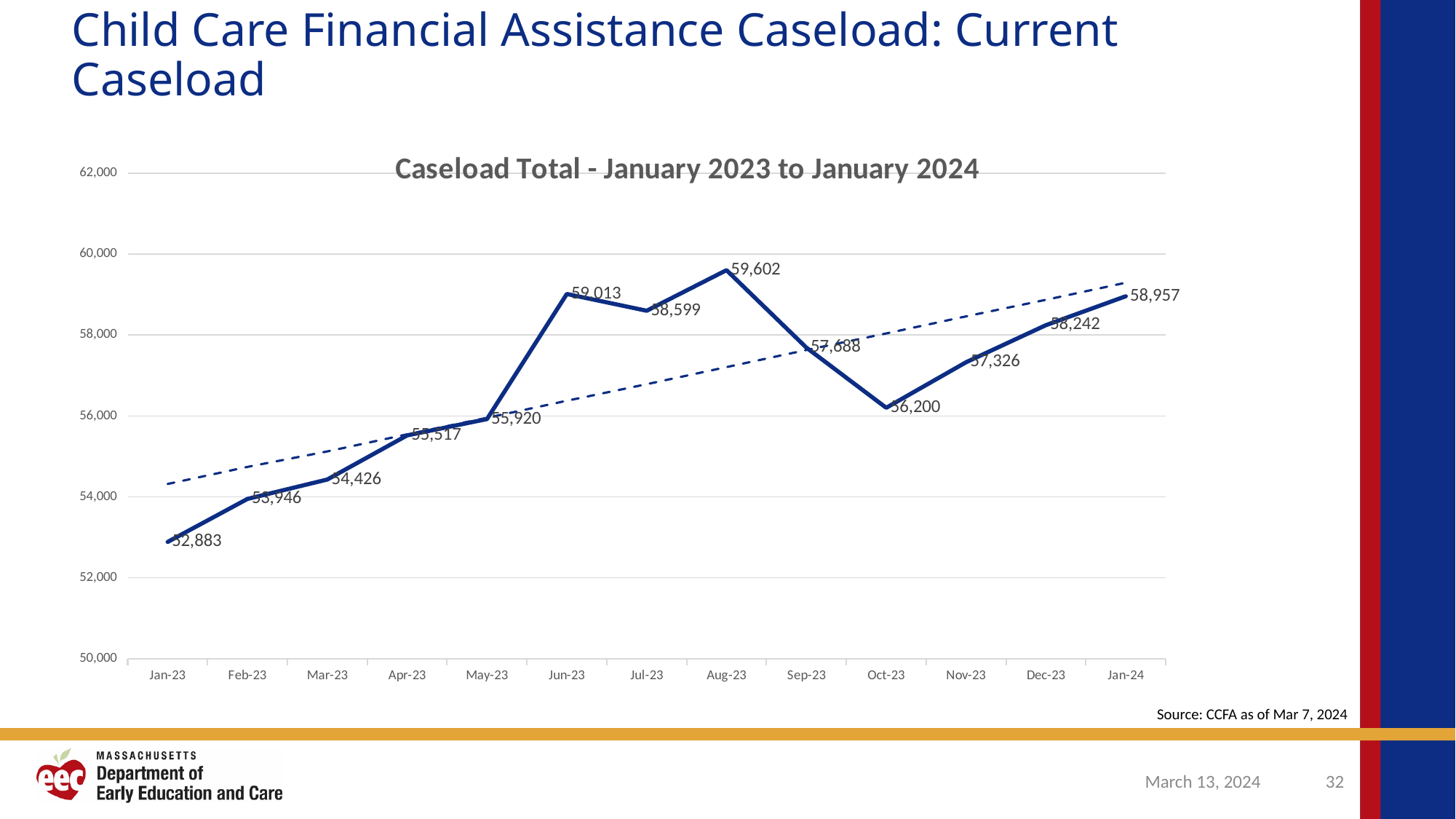
Which month has the highest caseload total? Aug-23 What is the caseload total for Jan-23? 52,883 What is the caseload total for Oct-23? 56,200 What is the difference between the caseload totals for Aug-23 and Oct-23? 3,402 What is the caseload total for Aug-23? 59,602 Which is larger, the caseload total for Jun-23 or for Jul-23? Jun-23 Which month has the lowest caseload total? Jan-23 Is the caseload total for Sep-23 greater or less than 58,000? less What is the difference between the caseload totals for Jan-24 and Jan-23? 6,074 What is the caseload total for Jan-24? 58,957 What kind of chart is shown on the slide? line chart How many months are plotted on the chart? 13